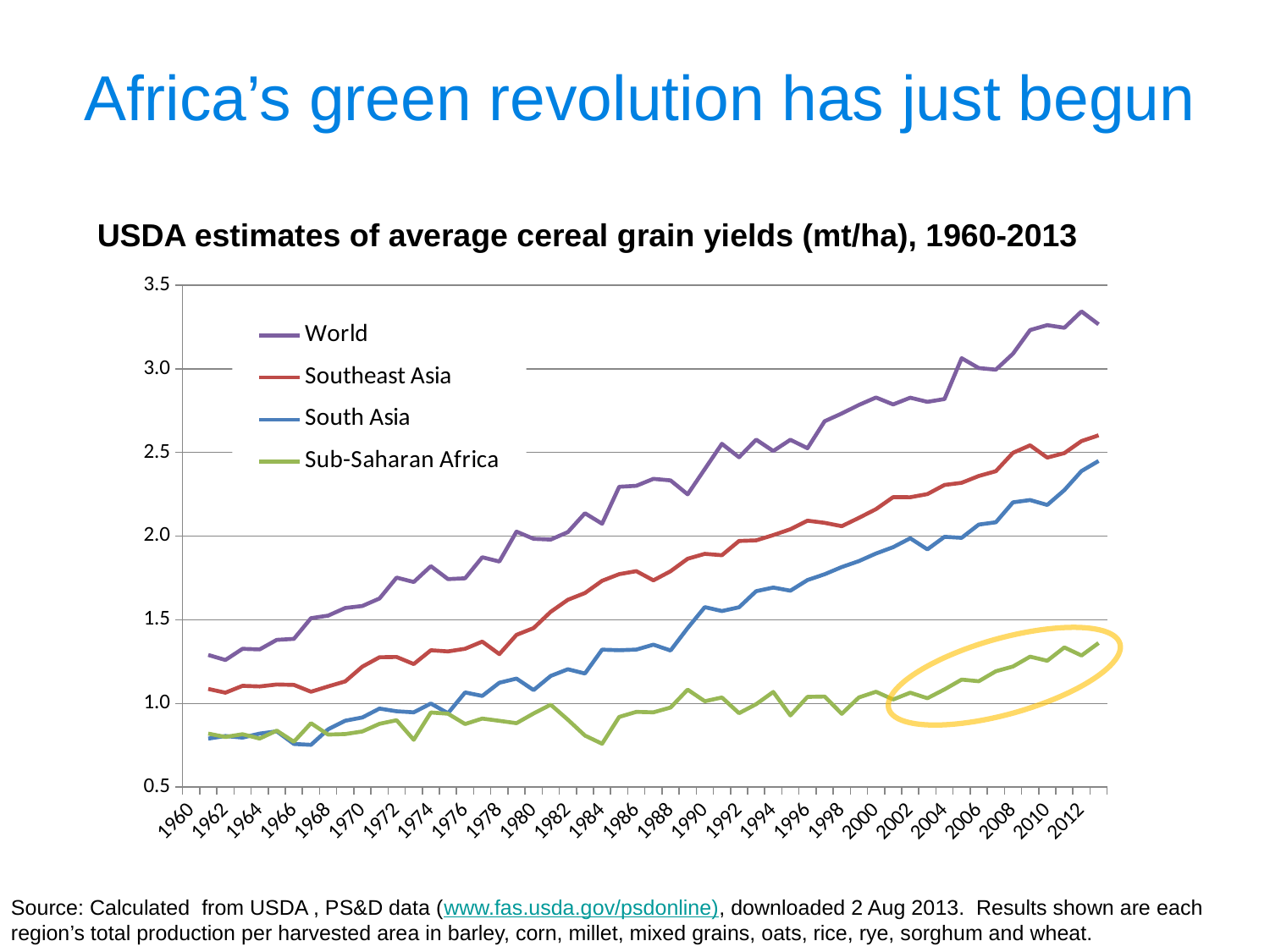
Is the Sub-Saharan Africa yield in 2012 greater or less than 1.5? less Is the Sub-Saharan Africa yield in 1984 greater or less than 1.0? less How many series does the chart's legend list? 4 In 2012, which is larger: the yield for Southeast Asia or for South Asia? Southeast Asia Which series has the lowest yield in 2012? Sub-Saharan Africa Which series has the highest yield in 2012? World What is the title of the chart? USDA estimates of average cereal grain yields (mt/ha), 1960-2013 What kind of chart is shown on the slide? Line chart Does the World yield generally rise or fall from 1960 to 2012? rise Is the South Asia yield in 2012 greater or less than 2.0? greater Which series is highlighted by the yellow oval on the chart? Sub-Saharan Africa